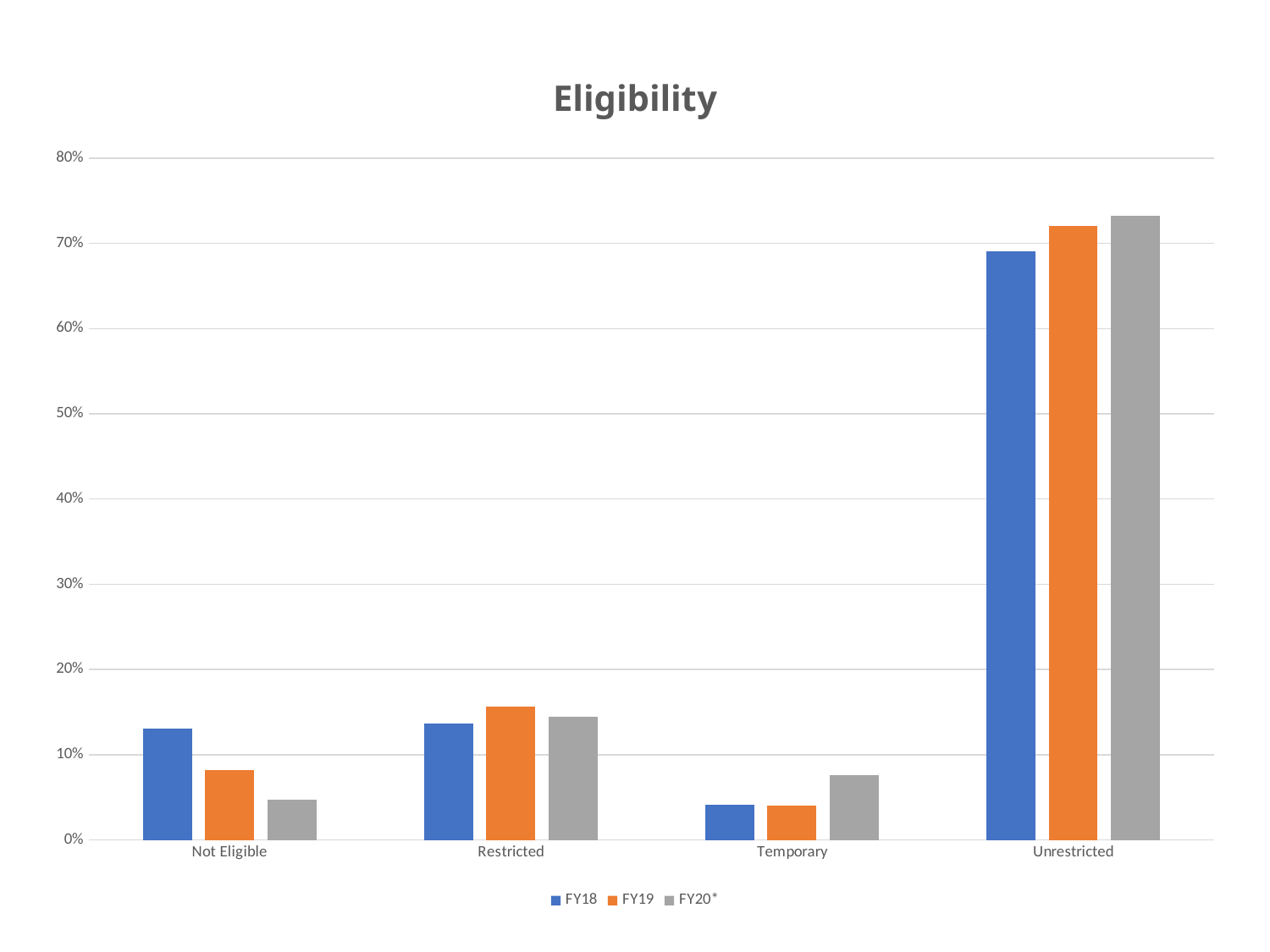
How many series does the legend list? 3 What kind of chart is shown on the slide? bar chart Which category has the highest FY18 value? Unrestricted Do the Not Eligible values rise or fall from FY18 to FY20*? fall For Temporary, which is larger: the FY18 value or the FY20* value? FY20* What is the title of the chart? Eligibility Is the FY20* value for Not Eligible greater or less than 10%? less How many categories are shown on the x axis? 4 Is the FY18 value for Unrestricted greater or less than 60%? greater Is the FY19 value for Restricted greater or less than 10%? greater Which category has the lowest FY19 value? Temporary For Not Eligible, which is larger: the FY18 value or the FY19 value? FY18